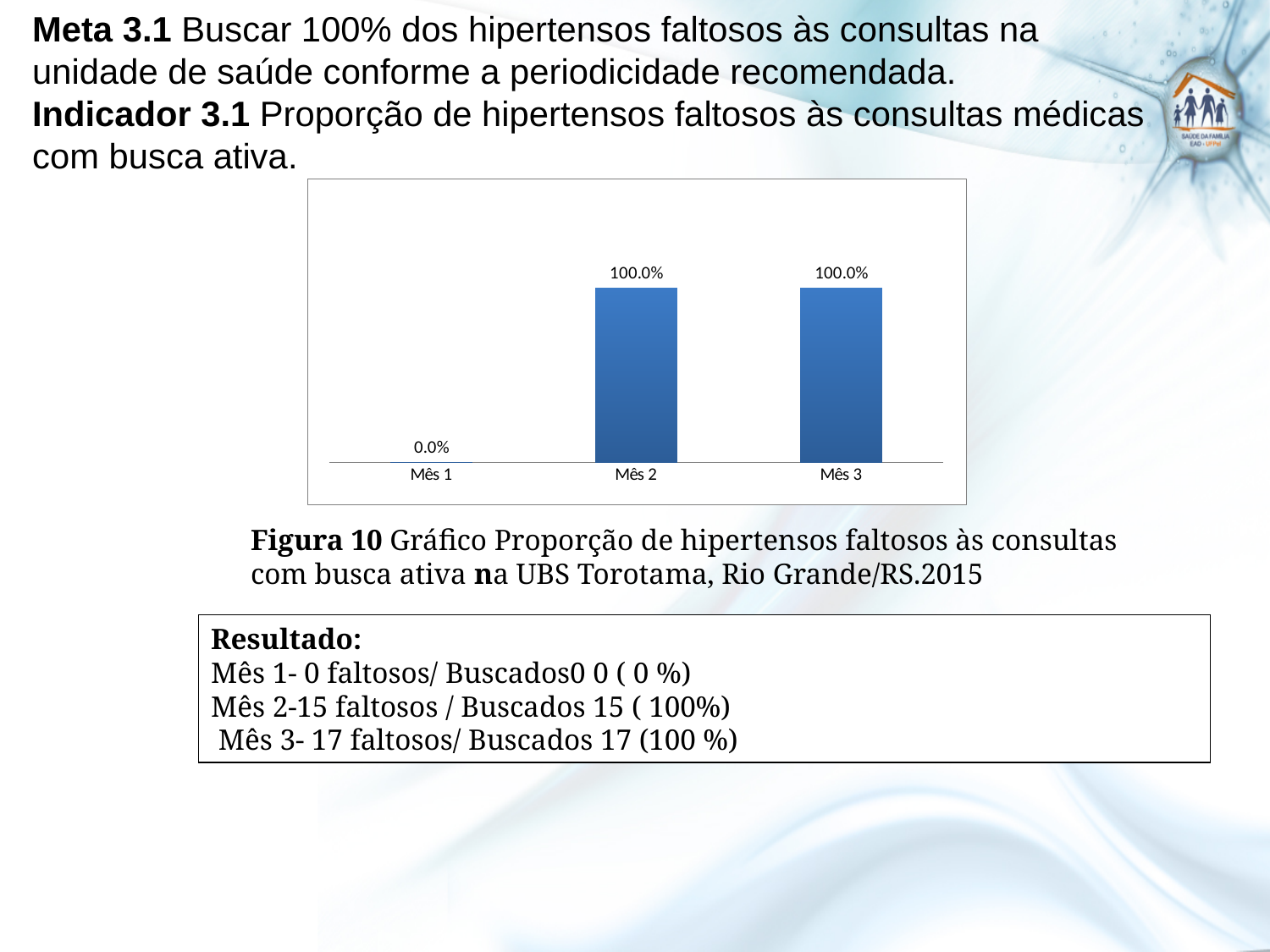
Which is larger, the value for Mês 1 or the value for Mês 3? Mês 3 Do the values rise or fall from Mês 1 to Mês 2? rise How many categories are shown on the x axis? 3 What is the value for Mês 2? 100.0% Which category has the lowest value? Mês 1 What is the value for Mês 3? 100.0% What is the label of the first category on the x axis? Mês 1 Are the values for Mês 2 and Mês 3 equal? yes What is the value for Mês 1? 0.0% What colour are the bars in the chart? blue What kind of chart is shown on the slide? bar chart What is the difference between the values for Mês 2 and Mês 1? 100.0%